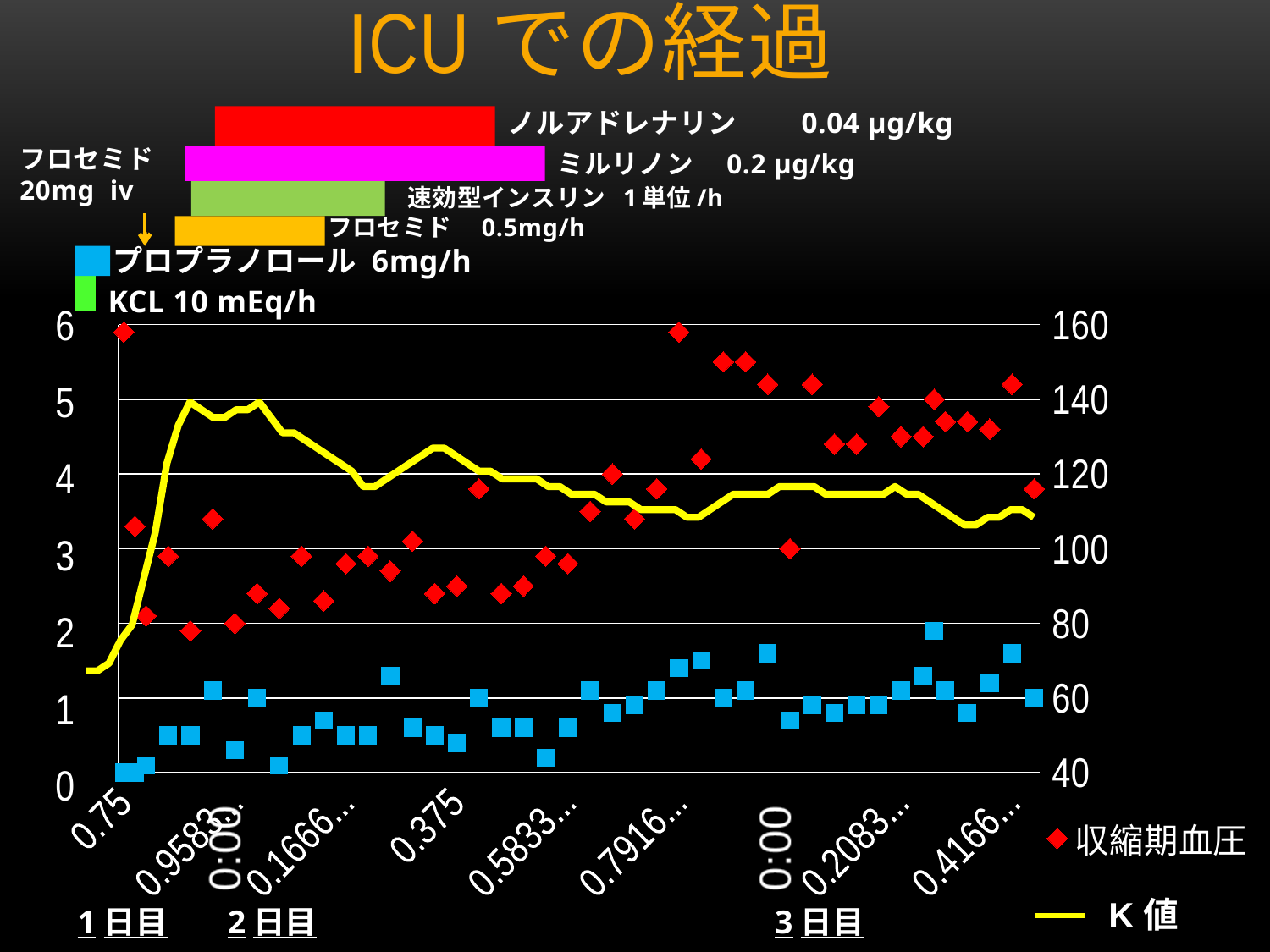
How many series does the chart legend list? 2 Is the 収縮期血圧 point near the 0.7916… label that sits at the top of the chart greater or less than 140? greater Which series is shown with red diamond markers? 収縮期血圧 Is the K 値 value at the far right end of the chart greater or less than 4? less Is the K 値 value at the very start of the line (far left) greater or less than 2? less What colour is the K 値 line? yellow Do the 収縮期血圧 values generally rise or fall from the middle of the chart (around 0.375) to the right end? rise Does the K 値 line rise or fall between its peak near the start and the right end of the chart? fall What kind of chart is used to show the K 値 series? line chart